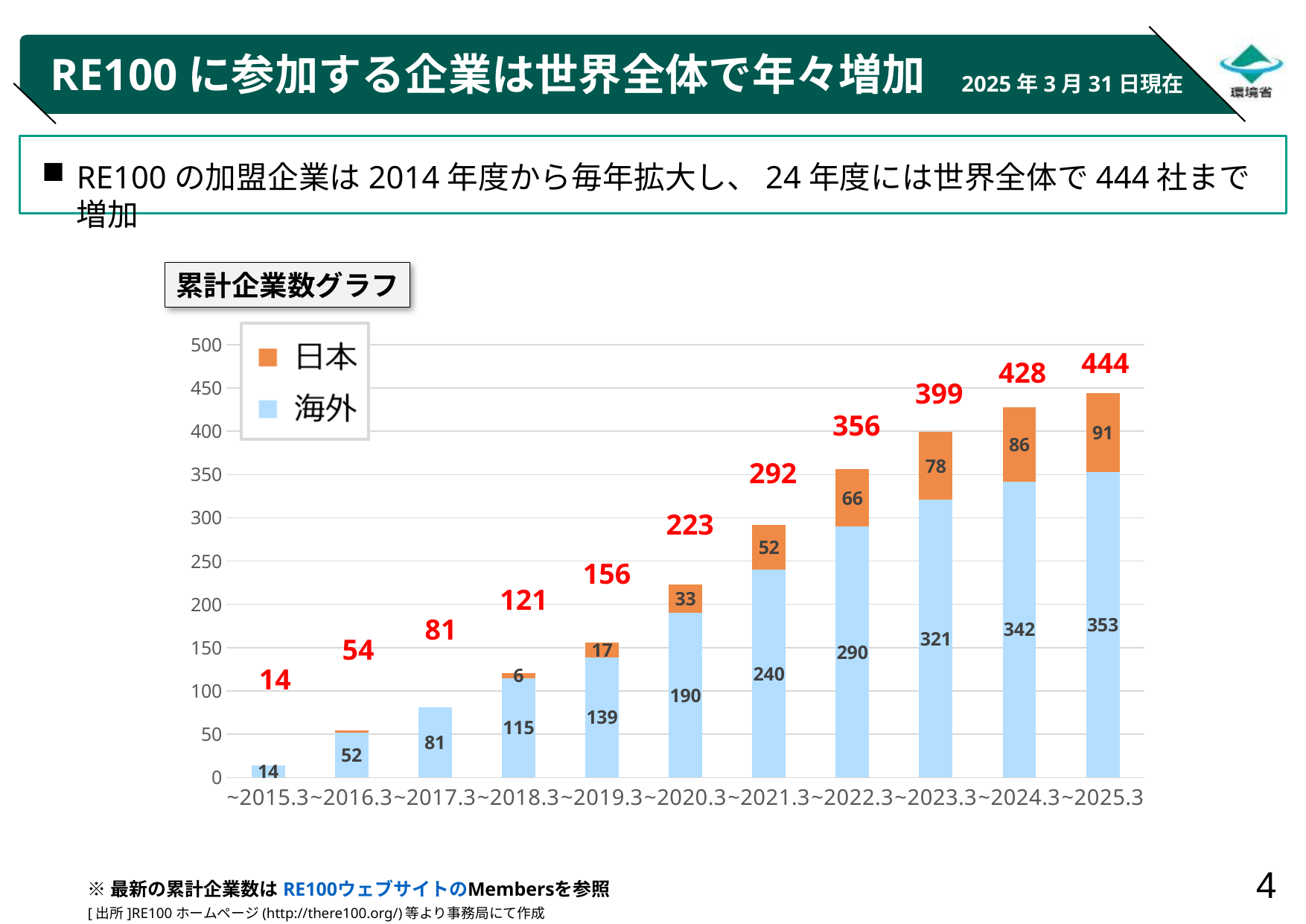
What is the 日本 (Japan) value for ~2021.3? 52 Which is larger, the 日本 value for ~2020.3 or the 日本 value for ~2019.3? ~2020.3 Which period has the highest total number of companies? ~2025.3 What is the 海外 (overseas) value for ~2025.3? 353 Is the total for ~2021.3 greater or less than 250? greater Which period has the lowest total number of companies? ~2015.3 How many periods are shown on the x axis? 11 What is the difference between the 海外 values for ~2024.3 and ~2023.3? 21 What kind of chart is shown on the slide? stacked bar chart What is the total shown above the stacked bar for ~2022.3? 356 How many series does the legend list? 2 Do the total values rise or fall from ~2015.3 to ~2025.3? rise